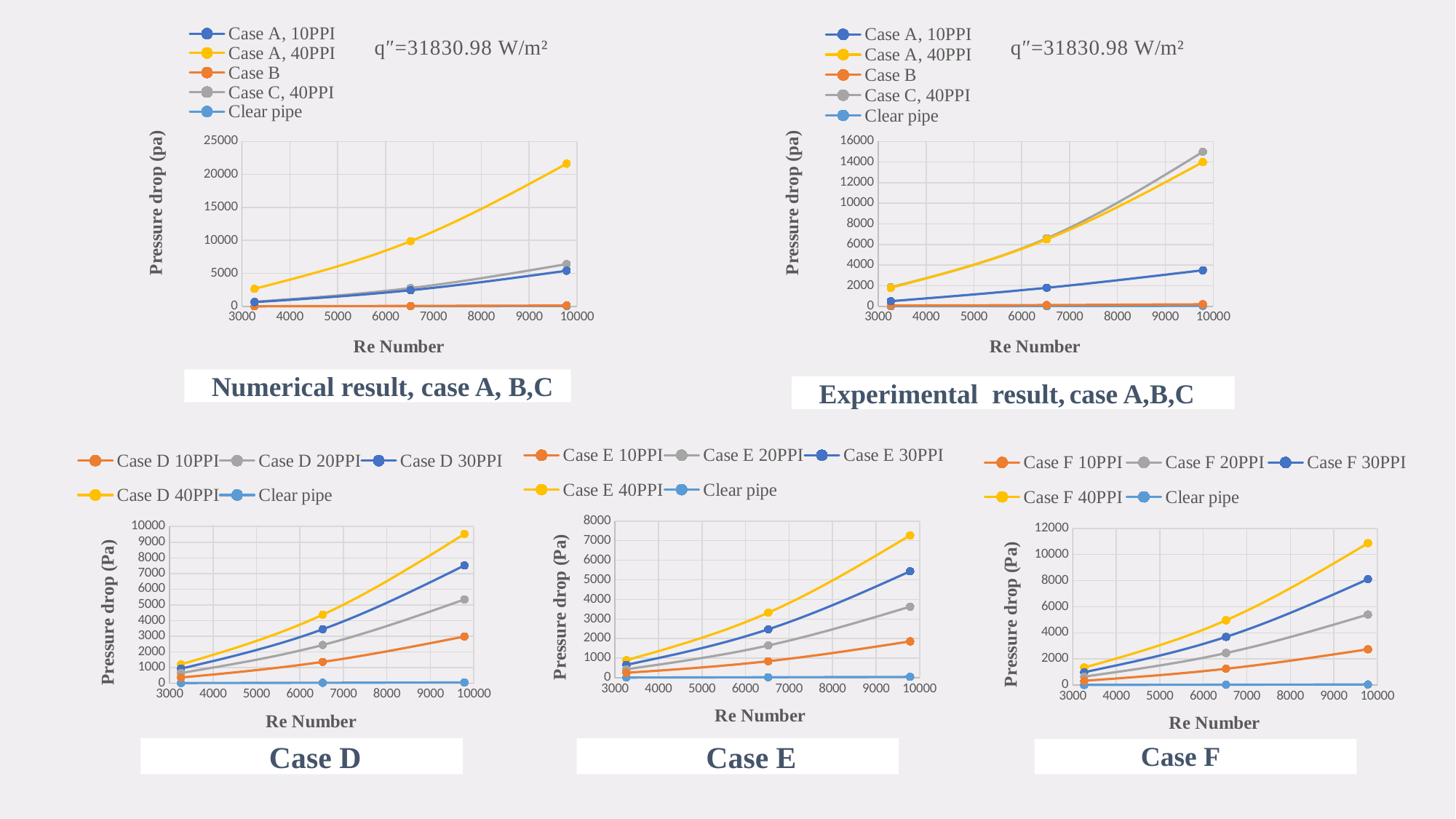
In the 'Case E' chart, is the pressure drop for Case E 40PPI at the highest Re number greater or less than 7000? greater In the 'Numerical result, case A, B,C' chart, which series has the highest pressure drop at the largest Re number? Case A, 40PPI In the 'Case D' chart, is the pressure drop for Case D 40PPI at the highest Re number greater or less than 9000? greater How many series does the legend of the 'Numerical result, case A, B,C' chart list? 5 In the 'Case E' chart, how does the pressure drop for Case E 30PPI change as the Re number increases? It rises In the 'Case F' chart, is the pressure drop for Case F 40PPI at the highest Re number greater or less than 10000? greater What kind of chart is the 'Case D' chart? line chart In the 'Case D' chart, which is larger at the highest Re number: the pressure drop for Case D 30PPI or Case D 20PPI? Case D 30PPI How many data points are plotted for the Case F 40PPI series in the 'Case F' chart? 3